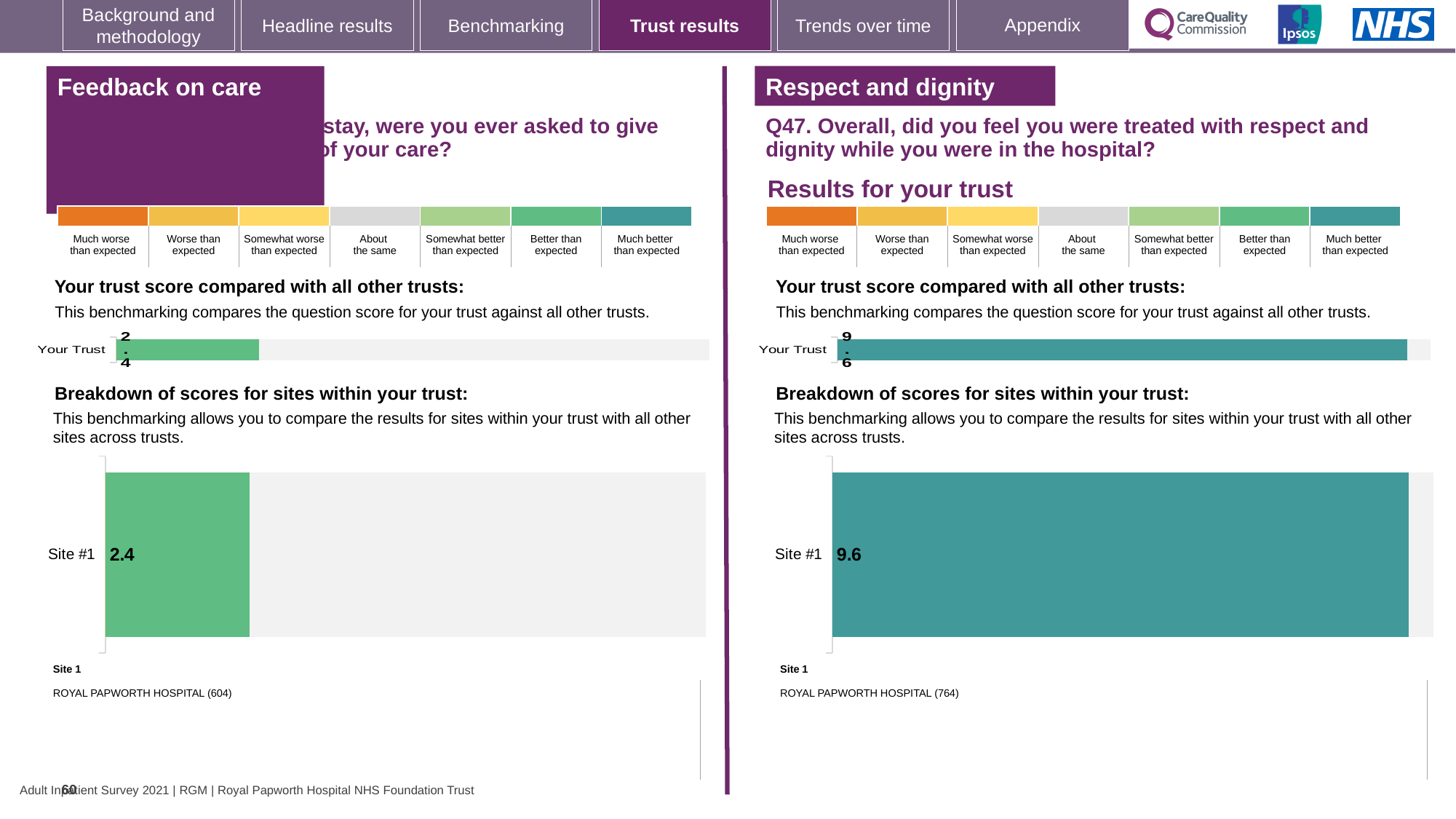
How many sites are shown in the 'Feedback on care' breakdown of scores chart? 1 On the 'Feedback on care' section, what is the score shown for Site #1 in the breakdown of scores chart? 2.4 What colour is the Site #1 bar in the 'Respect and dignity' breakdown of scores chart? Teal What colour is the Site #1 bar in the 'Feedback on care' breakdown of scores chart? Green On the 'Feedback on care' section, what is the value shown for 'Your Trust' in the trust score chart? 2.4 On the 'Respect and dignity' section, what is the score shown for Site #1 in the breakdown of scores chart? 9.6 What is the difference between the Site #1 score in the 'Respect and dignity' breakdown chart and the Site #1 score in the 'Feedback on care' breakdown chart? 7.2 How many sites are shown in the 'Respect and dignity' breakdown of scores chart? 1 What kind of chart is used to show the Site #1 score in the 'Feedback on care' breakdown of scores section? Bar chart On the 'Respect and dignity' section, what is the value shown for 'Your Trust' in the trust score chart? 9.6 Which hospital is listed as Site 1 below the 'Respect and dignity' breakdown chart? ROYAL PAPWORTH HOSPITAL (764) Which Site #1 score is larger: the one in the 'Feedback on care' breakdown chart or the one in the 'Respect and dignity' breakdown chart? Respect and dignity